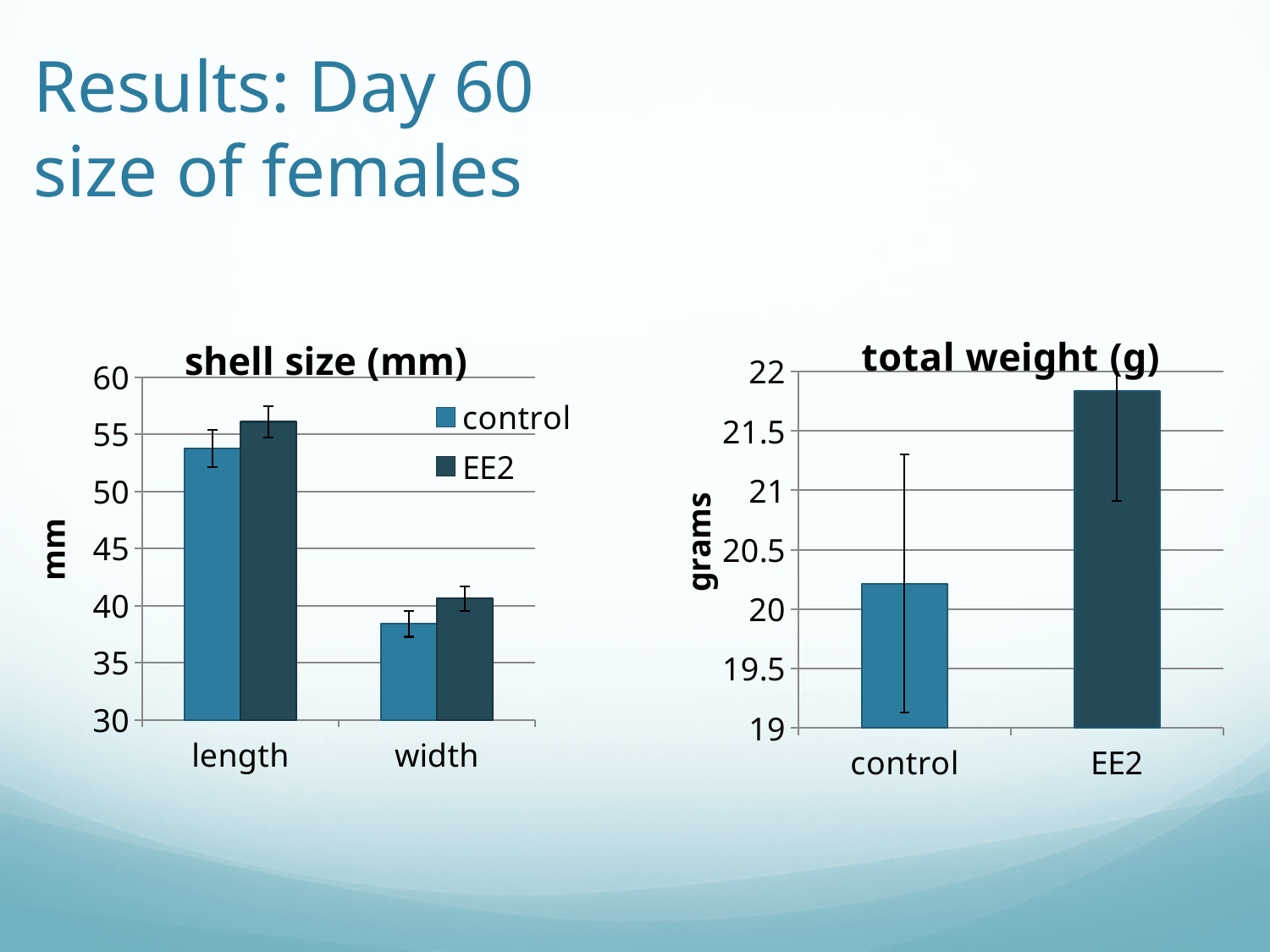
In the "total weight (g)" chart, is the value for EE2 greater or less than 21.5? greater In the "total weight (g)" chart, is the value for control greater or less than 20.5? less How many categories are shown on the x axis of the "shell size (mm)" chart? 2 In the "shell size (mm)" chart, which category has the lower values, length or width? width In the "shell size (mm)" chart, is the control value for length greater or less than 50? greater What is the y-axis label of the "shell size (mm)" chart? mm What is the y-axis label of the "total weight (g)" chart? grams What kind of chart is the "shell size (mm)" chart? bar chart In the "shell size (mm)" chart, which series has the larger value for length, control or EE2? EE2 In the "total weight (g)" chart, which category has the highest value? EE2 How many series does the legend of the "shell size (mm)" chart list? 2